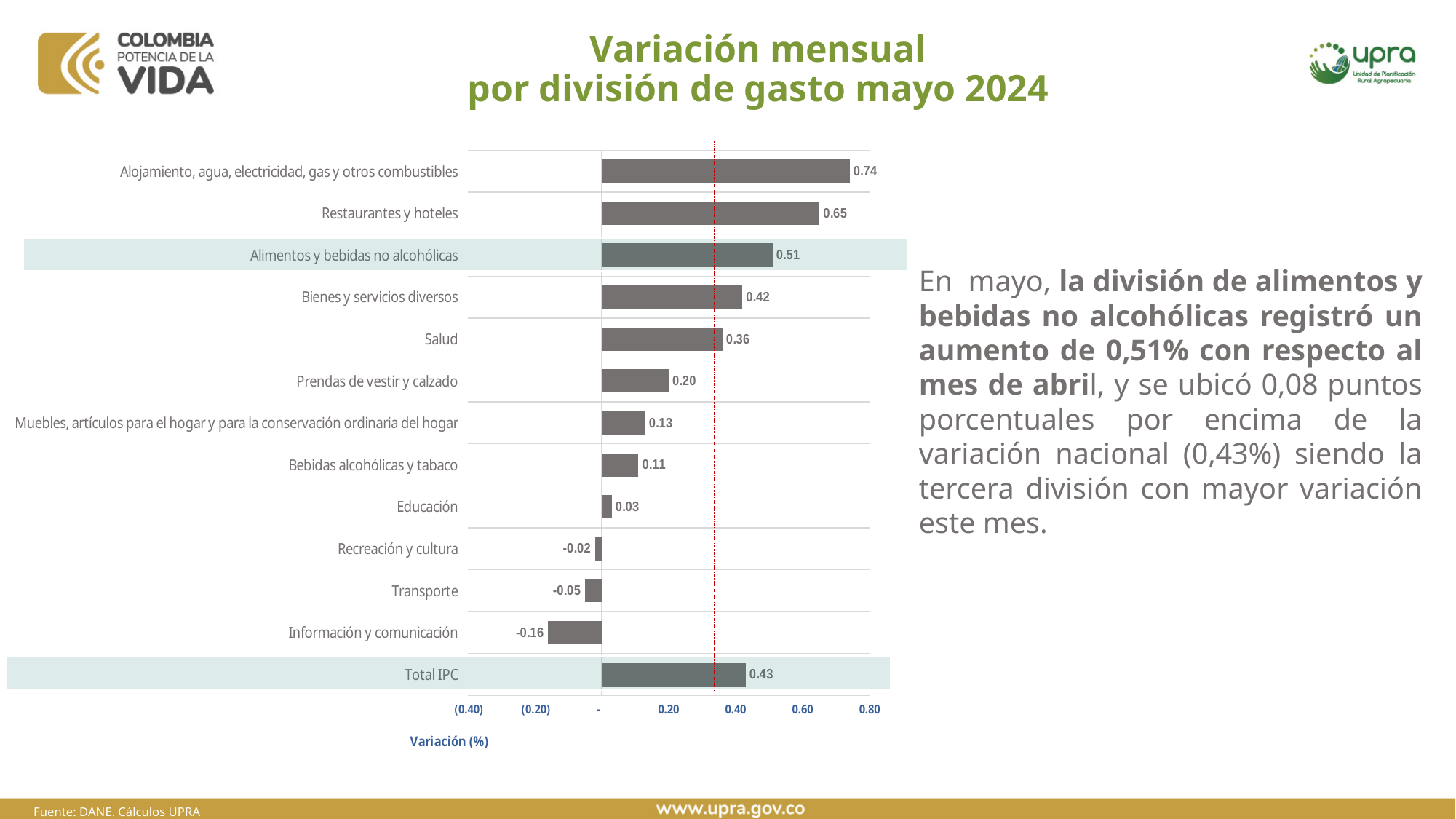
What kind of chart is shown on the slide? Bar chart What is the value for Alimentos y bebidas no alcohólicas? 0.51 Which is larger, the value for Bienes y servicios diversos or the value for Prendas de vestir y calzado? Bienes y servicios diversos How many categories have a negative value? 3 What is the label of the horizontal axis? Variación (%) What is the value for Información y comunicación? -0.16 How many categories are shown in the chart? 13 What is the value for Alojamiento, agua, electricidad, gas y otros combustibles? 0.74 What is the value for Total IPC? 0.43 What is the difference between Restaurantes y hoteles and Salud? 0.29 Which category has the lowest value? Información y comunicación Which category has the highest value? Alojamiento, agua, electricidad, gas y otros combustibles